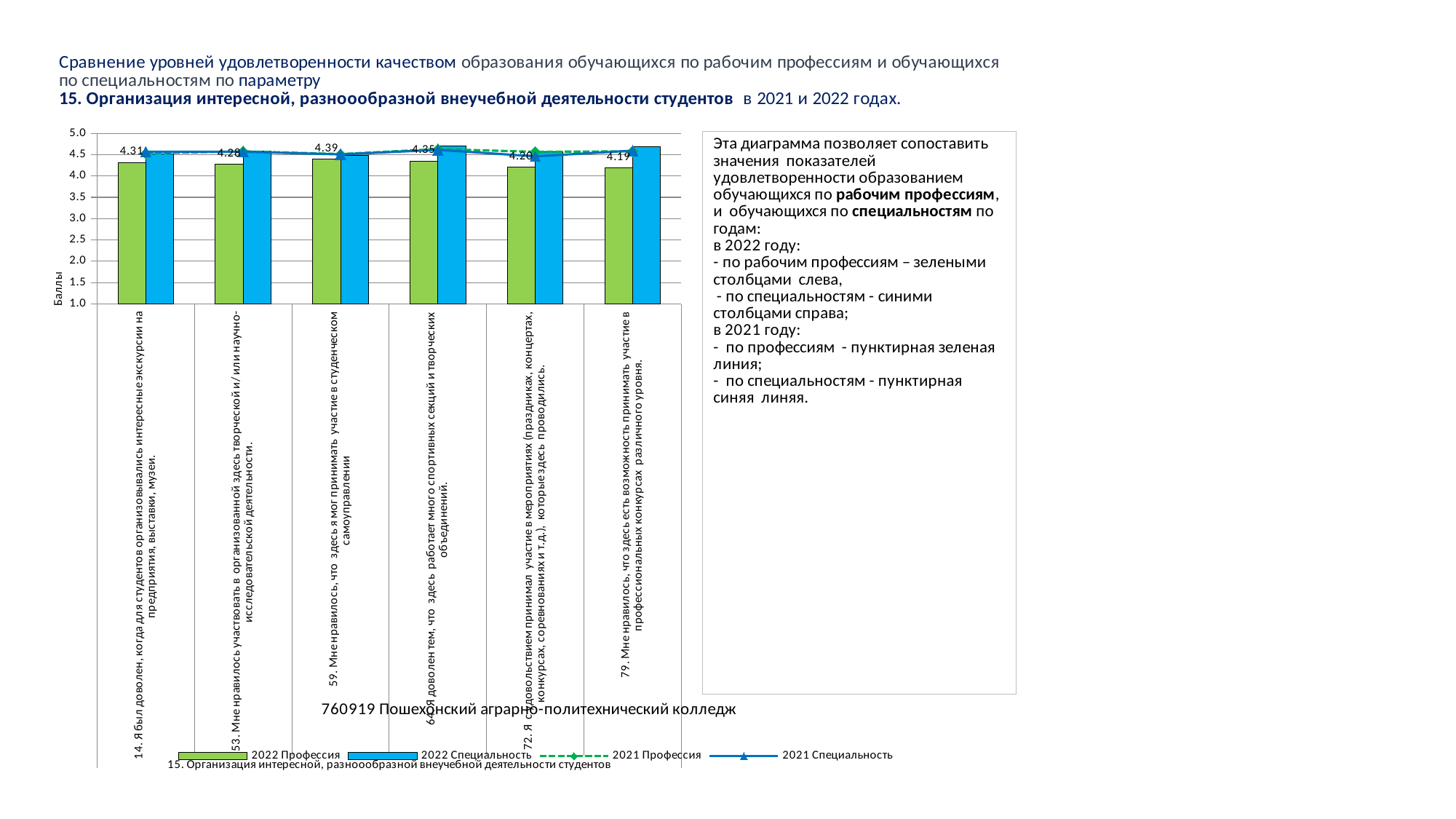
How many categories (survey statements) are shown on the x axis? 6 What is the 2022 Профессия value for category 79 (Мне нравилось, что здесь есть возможность принимать участие в профессиональных конкурсах)? 4.19 What is the label of the vertical axis? Баллы Which is larger for 2022 Профессия: category 14 or category 53? Category 14 Which category has the lowest 2022 Профессия value? 79 What is the 2022 Профессия value for category 59 (Мне нравилось, что здесь я мог принимать участие в студенческом самоуправлении)? 4.39 Is the 2022 Специальность value for category 14 greater or less than 4.0? greater Which category has the highest 2022 Профессия value? 59 What kind of chart is used to show the 2022 series? bar chart How many series does the legend list? 4 What is the 2022 Профессия value for category 14 (Я был доволен, когда для студентов организовывались интересные экскурсии)? 4.31 What is the difference between the highest and lowest 2022 Профессия values (categories 59 and 79)? 0.20